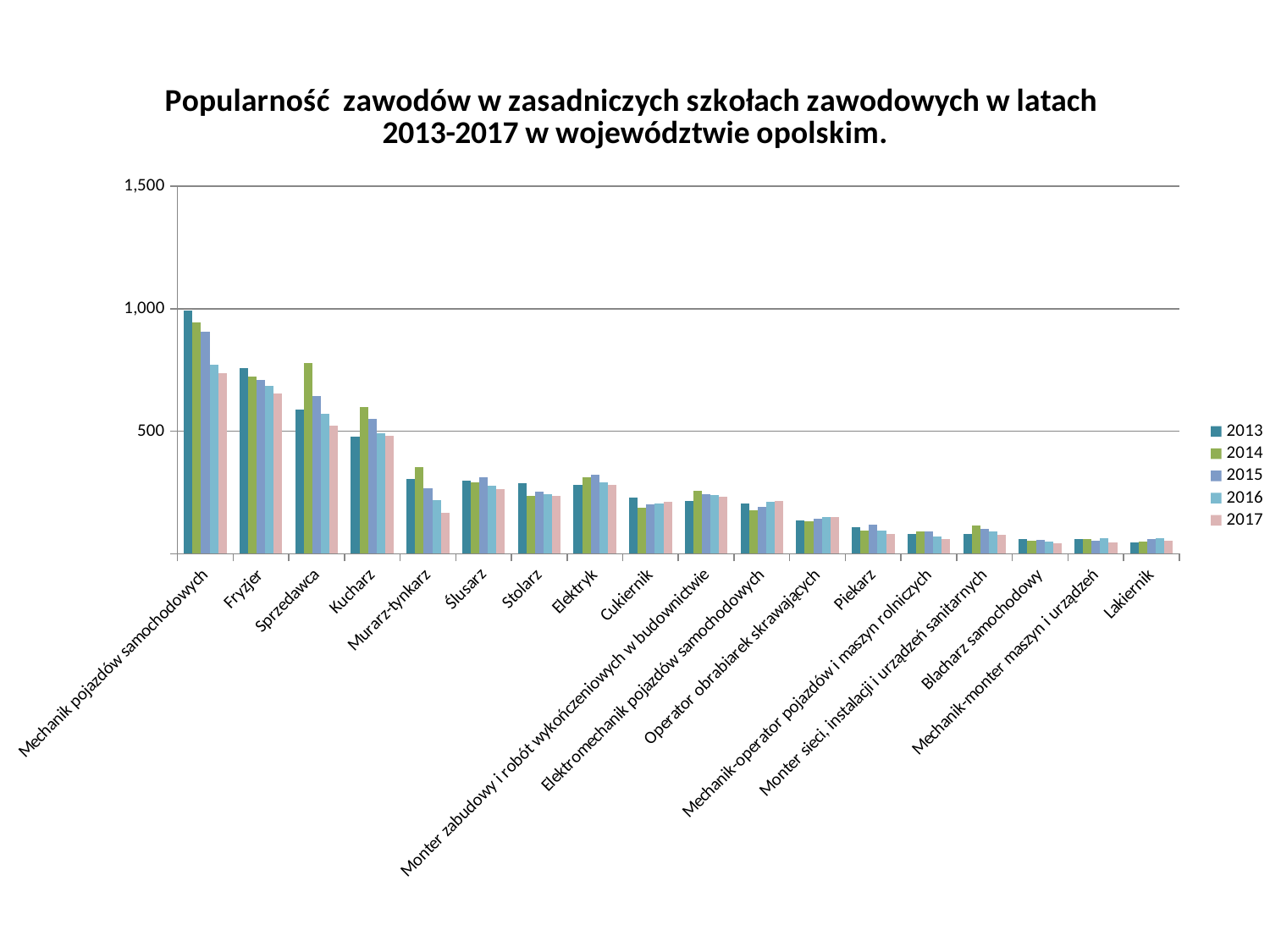
What kind of chart is shown on the slide? bar chart Is the 2014 value for Sprzedawca greater or less than 500? greater How many occupation categories are shown on the x axis? 18 Which occupation has the highest value in 2013? Mechanik pojazdów samochodowych Is the 2013 value for Fryzjer greater or less than 1,000? less Which is larger in 2013: Fryzjer or Sprzedawca? Fryzjer Do the values for Mechanik pojazdów samochodowych rise or fall from 2013 to 2017? fall Is the 2014 value for Murarz-tynkarz greater or less than 500? less Which is larger in 2013: Kucharz or Murarz-tynkarz? Kucharz Which years are listed in the legend? 2013, 2014, 2015, 2016, 2017 How many series does the legend list? 5